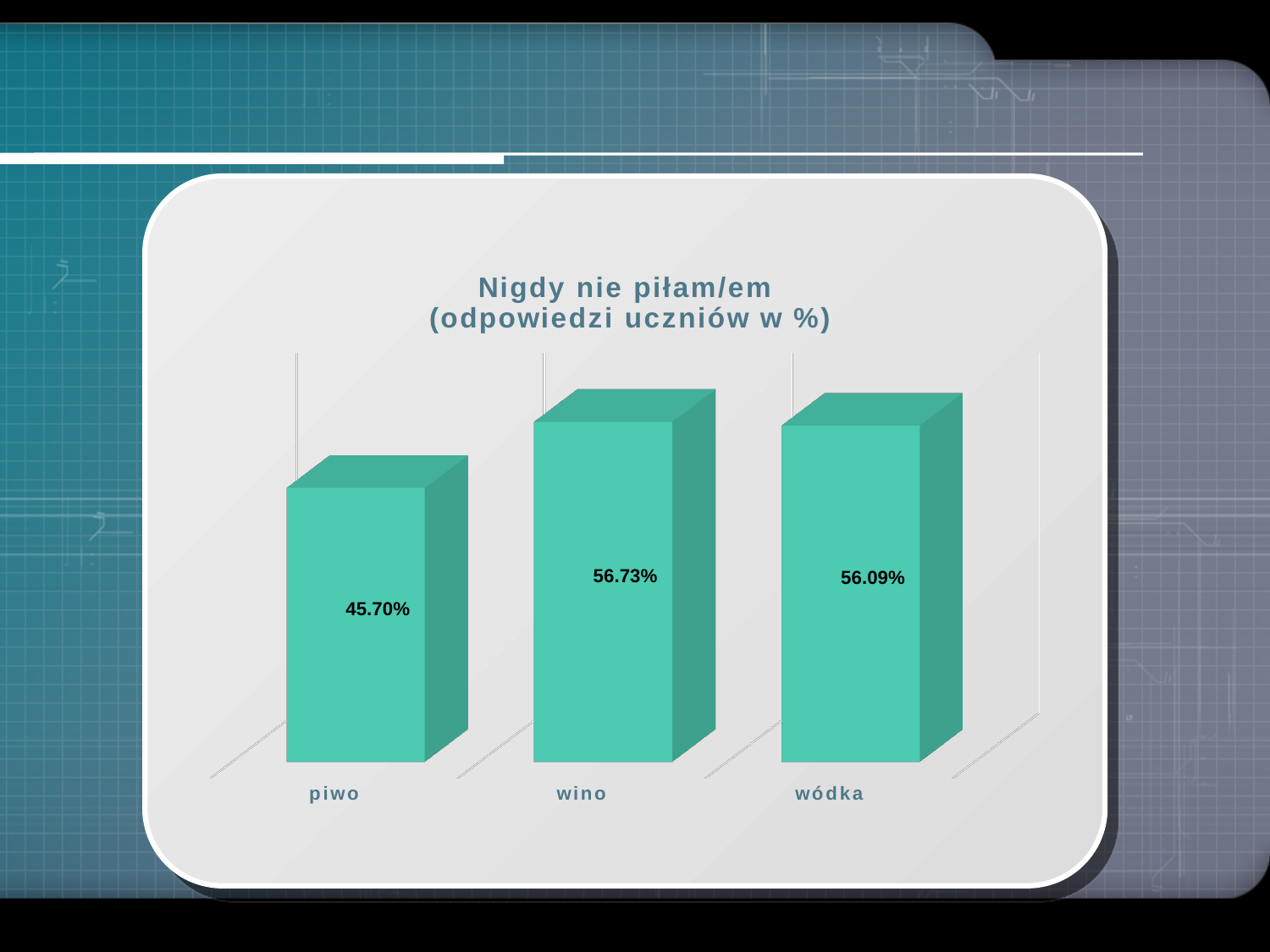
What is the difference between the values for wino and piwo? 11.03 percentage points Which category has the highest value? wino What is the difference between the values for wino and wódka? 0.64 percentage points What kind of chart is shown on the slide? bar chart How many categories are shown in the chart? 3 What is the value for wino? 56.73% What is the value for piwo? 45.70% What is the value for wódka? 56.09% Which category has the lowest value? piwo Which is larger, the value for piwo or the value for wódka? wódka What is the difference between the values for wódka and piwo? 10.39 percentage points What is the title of the chart? Nigdy nie piłam/em (odpowiedzi uczniów w %)